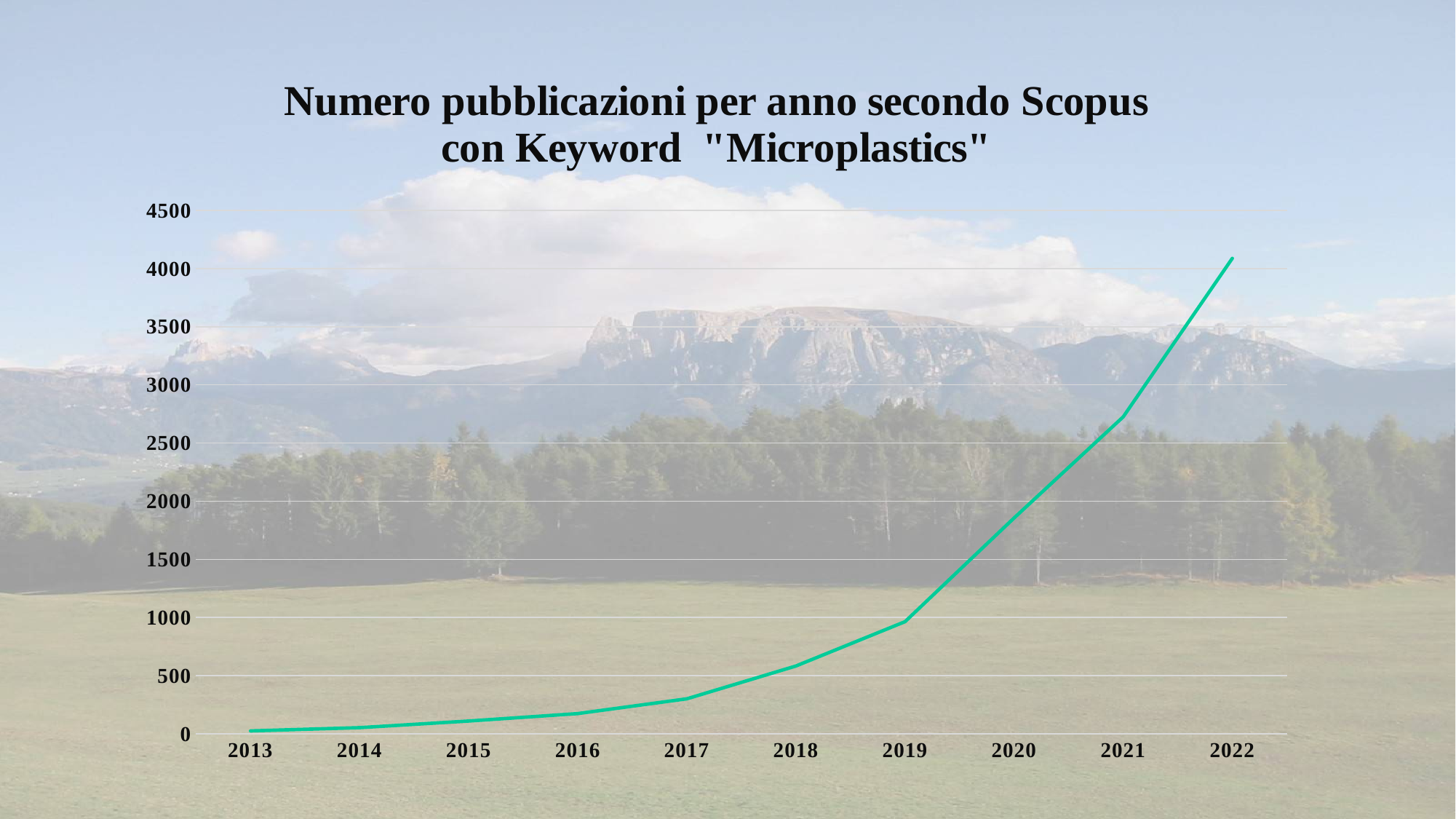
Which year has the highest number of publications? 2022 Is the value for 2018 greater or less than 1000? less Is the value for 2017 greater or less than 500? less What keyword is named in the chart title? Microplastics Is the value for 2020 greater or less than 1500? greater Which is larger, the value for 2021 or the value for 2019? 2021 Which year has the lowest number of publications? 2013 What kind of chart is shown on the slide? line chart Do the values rise or fall from 2013 to 2022? rise How many years are plotted along the x axis? 10